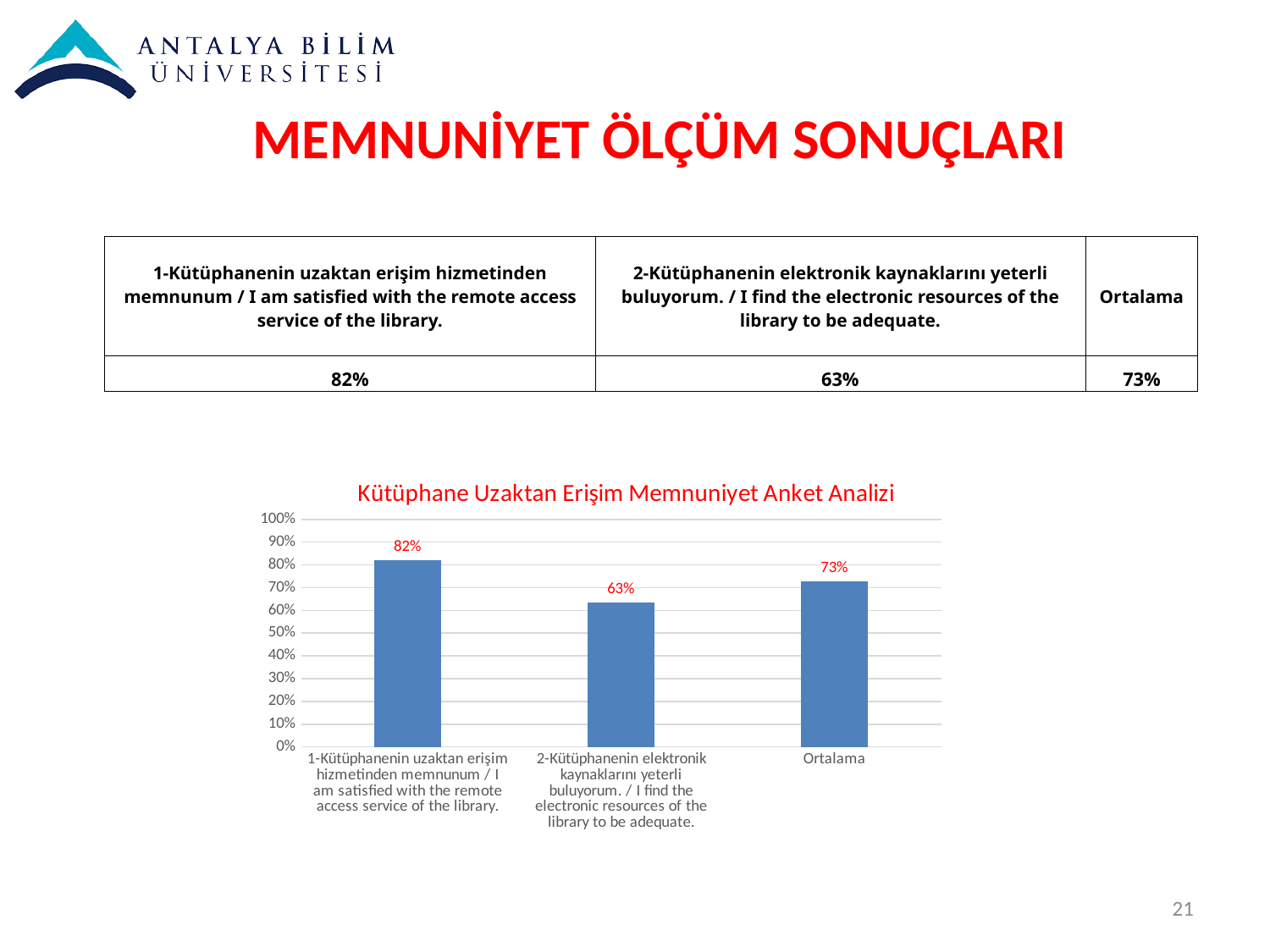
Is the value for Ortalama greater or less than 70%? greater Which category has the lowest value? 2-Kütüphanenin elektronik kaynaklarını yeterli buluyorum. / I find the electronic resources of the library to be adequate. What is the difference between the remote access satisfaction value and the electronic resources adequacy value? 19% What kind of chart is shown on the slide? Bar chart What is the value for Ortalama? 73% What is the highest value shown on the y axis of the chart? 100% What is the value for the electronic resources adequacy category (2-Kütüphanenin elektronik kaynaklarını yeterli buluyorum)? 63% Which category has the highest value? 1-Kütüphanenin uzaktan erişim hizmetinden memnunum / I am satisfied with the remote access service of the library. How many categories are shown on the chart? 3 What is the value for the remote access service satisfaction category (1-Kütüphanenin uzaktan erişim hizmetinden memnunum)? 82% What is the title of the chart? Kütüphane Uzaktan Erişim Memnuniyet Anket Analizi Which is larger: the value for Ortalama or the value for the electronic resources adequacy category? Ortalama